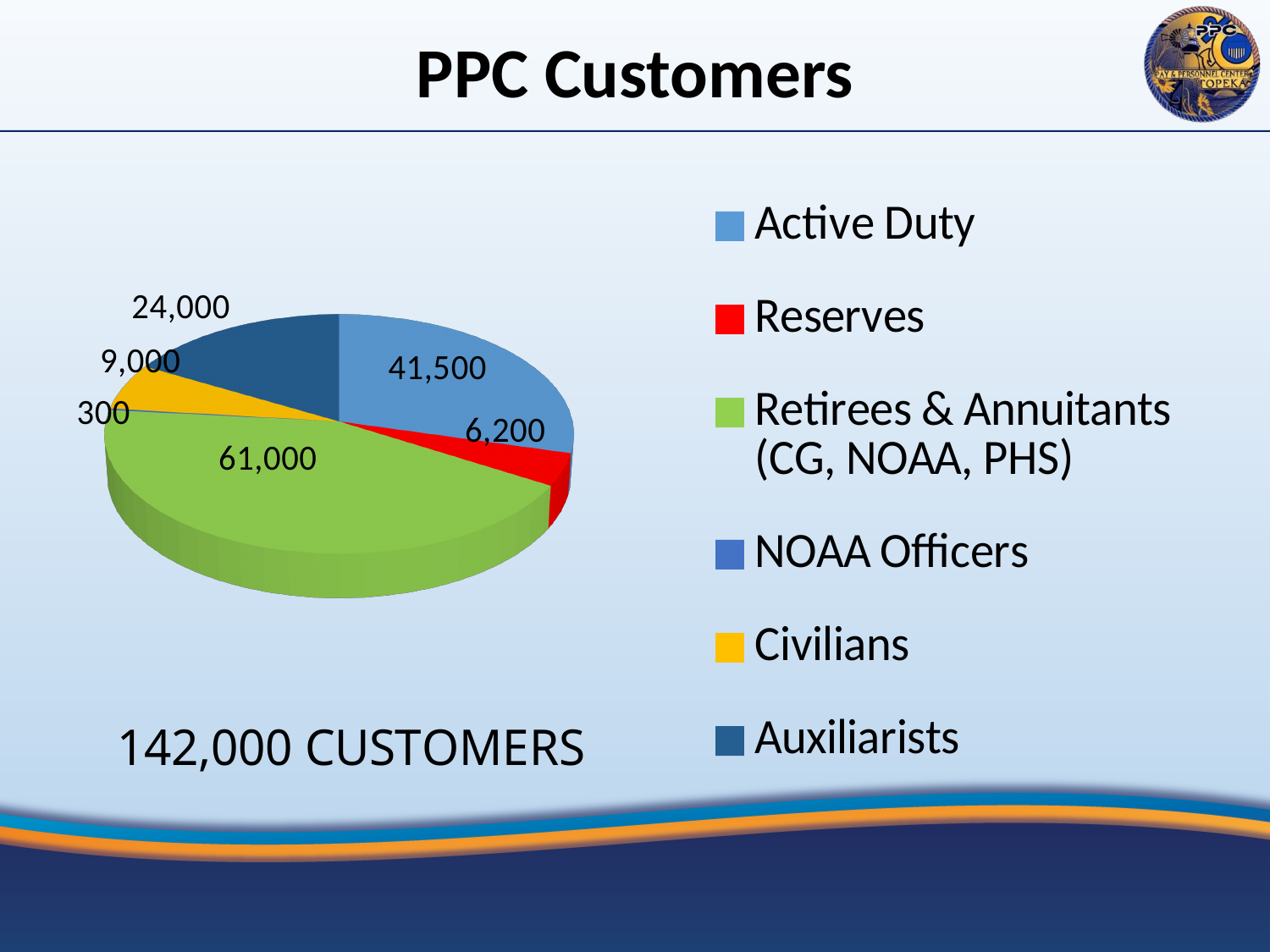
What colour represents Reserves in the legend? Red Which is larger, Civilians or Reserves? Civilians How many customers are Active Duty? 41,500 What is the value for Auxiliarists? 24,000 What is the difference between the Retirees & Annuitants value and the Active Duty value? 19,500 What is the value for Retirees & Annuitants (CG, NOAA, PHS)? 61,000 What type of chart is shown on the slide? Pie chart How many customers are NOAA Officers? 300 Which customer category has the largest slice of the pie? Retirees & Annuitants (CG, NOAA, PHS) Which customer category has the smallest slice of the pie? NOAA Officers How many categories does the pie chart have? 6 What is the total number of customers shown on the slide? 142,000